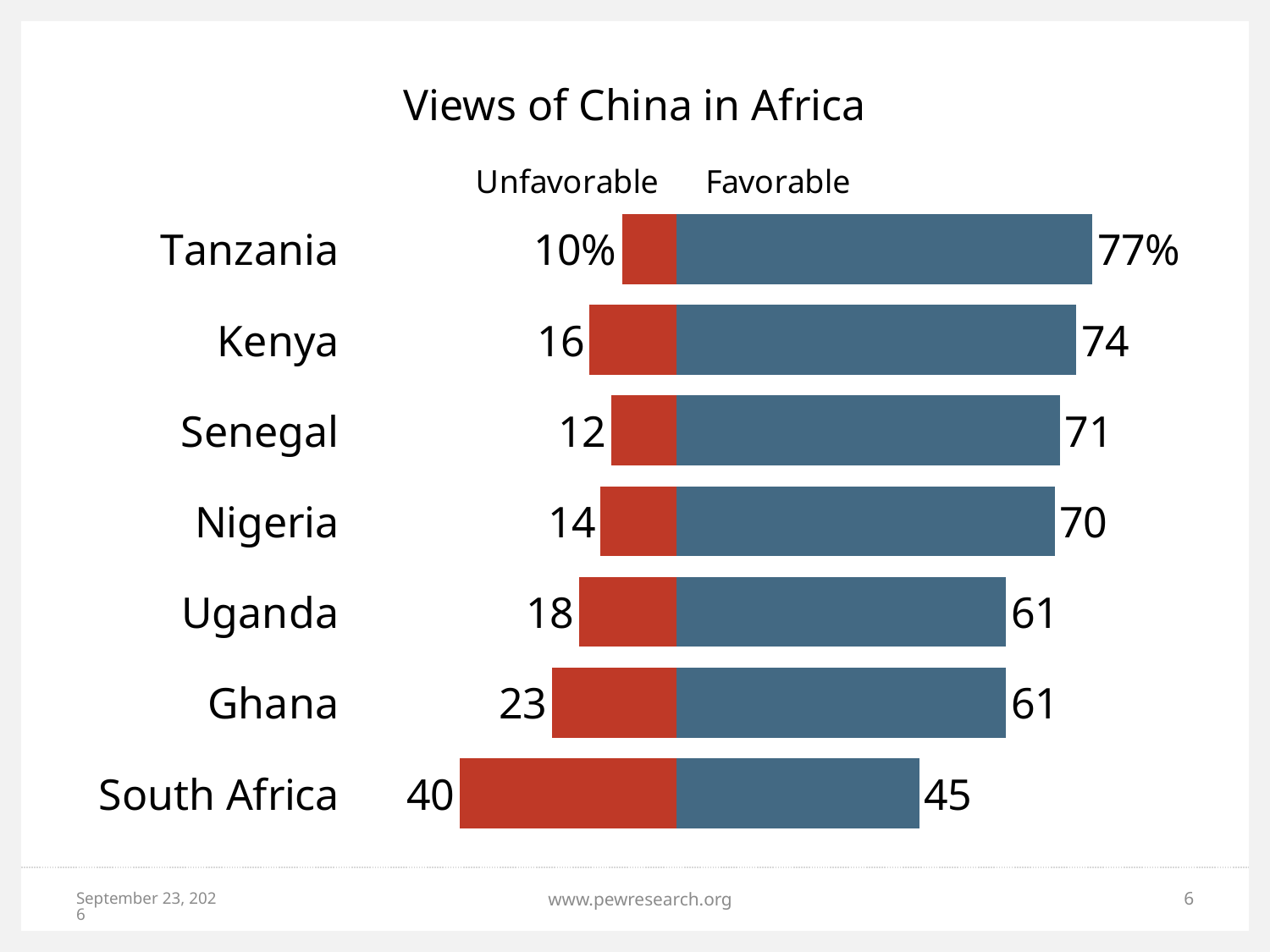
How many countries are shown in the chart? 7 How many series does the chart show? 2 Which is larger, the Favorable value for Senegal or the Favorable value for Nigeria? Senegal What kind of chart is this? Bar chart What is the title of the chart? Views of China in Africa Which country has the highest Favorable value? Tanzania What is the Unfavorable value for South Africa? 40 Which country has the lowest Unfavorable value? Tanzania Which country has the highest Unfavorable value? South Africa What is the difference between the Favorable and Unfavorable values for Kenya? 58 What is the Favorable value for Tanzania? 77% What is the Favorable value for Uganda? 61